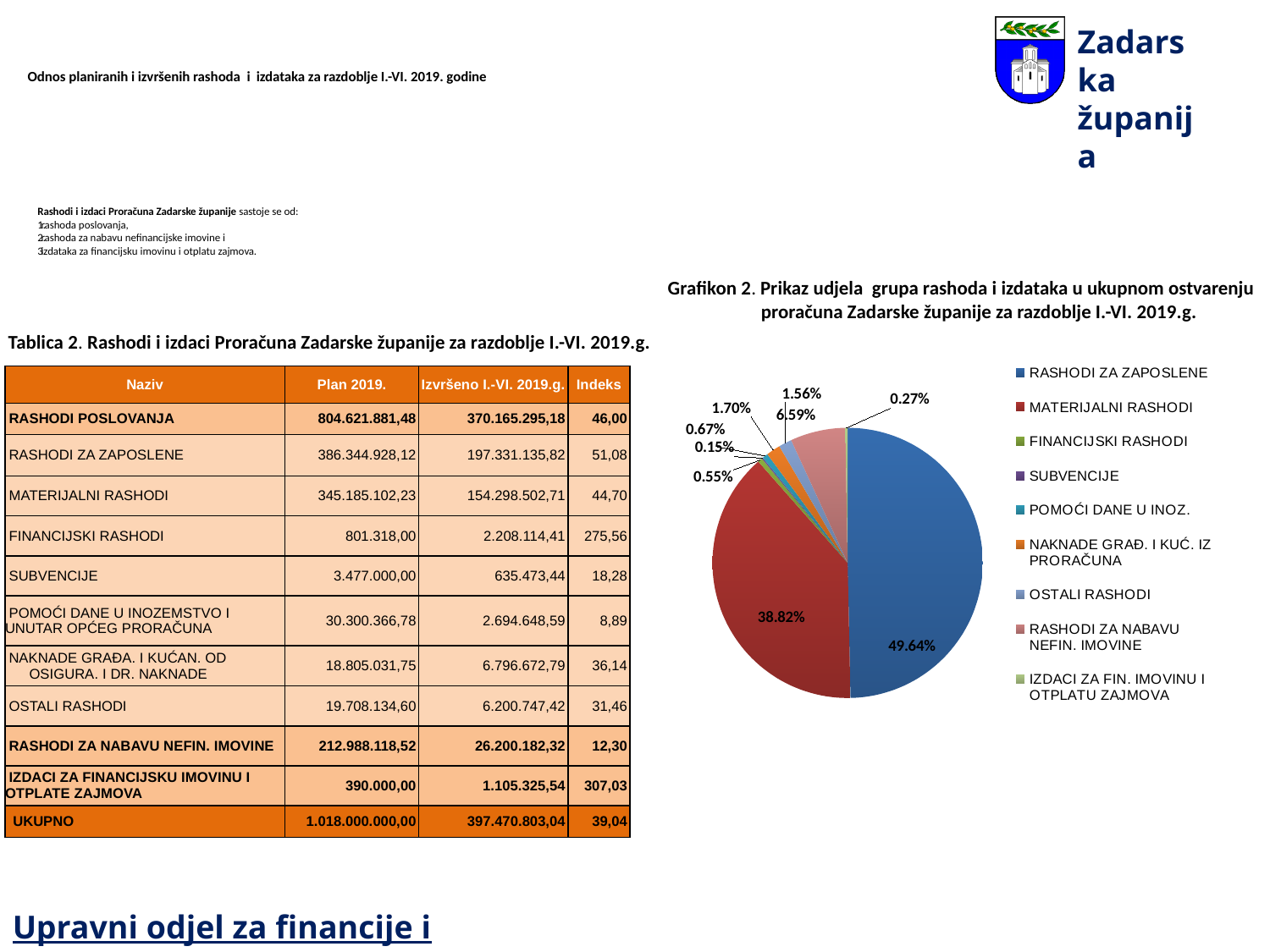
What share of the pie does IZDACI ZA FIN. IMOVINU I OTPLATU ZAJMOVA have? 0.27% What type of chart is shown in Grafikon 2? pie chart Which is larger in the pie chart: the share of MATERIJALNI RASHODI or the share of RASHODI ZA NABAVU NEFIN. IMOVINE? MATERIJALNI RASHODI What is the smallest percentage labelled on the pie chart? 0.15% What colour is the slice for RASHODI ZA ZAPOSLENE in the pie chart? blue What share of the pie does MATERIJALNI RASHODI have? 38.82% How many categories does the legend of the pie chart list? 9 What share of the pie does RASHODI ZA NABAVU NEFIN. IMOVINE have? 6.59% What is the combined share of RASHODI ZA ZAPOSLENE and MATERIJALNI RASHODI in the pie chart? 88.46% Which category has the largest slice of the pie chart? RASHODI ZA ZAPOSLENE What is the difference between the shares of RASHODI ZA ZAPOSLENE and MATERIJALNI RASHODI? 10.82%